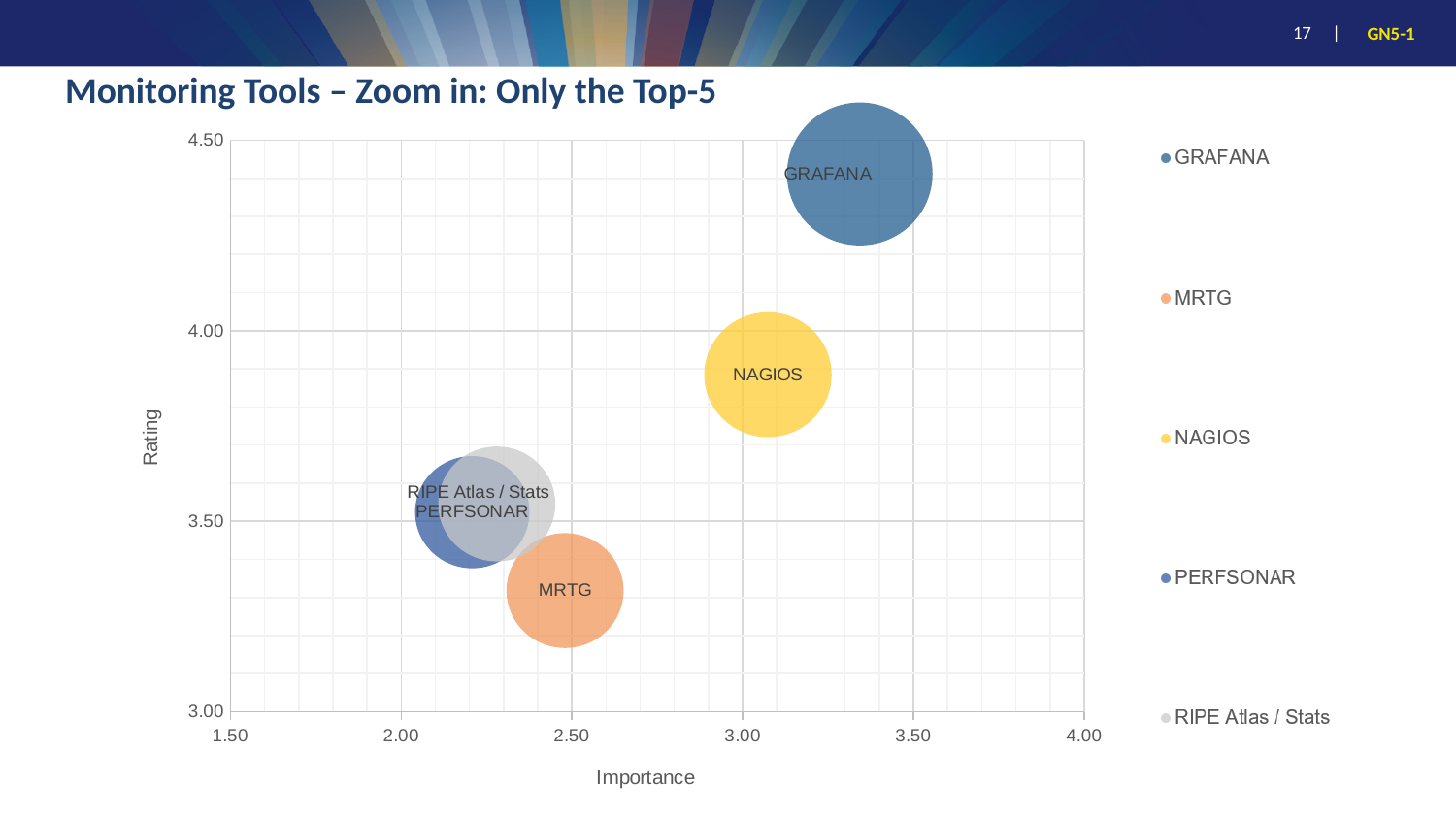
What is the label of the horizontal axis? Importance Which has the higher Rating, NAGIOS or MRTG? NAGIOS Which tool has the highest Importance? GRAFANA Which tool has the highest Rating? GRAFANA What kind of chart is shown on the slide? Bubble chart How many monitoring tools are plotted on the chart? 5 Is the Rating for MRTG greater or less than 3.50? less What is the title of the chart on the slide? Monitoring Tools – Zoom in: Only the Top-5 How many entries does the legend list? 5 Which tool has the lowest Rating? MRTG Is the Rating for GRAFANA greater or less than 4.00? greater Is the Importance for PERFSONAR greater or less than 2.50? less